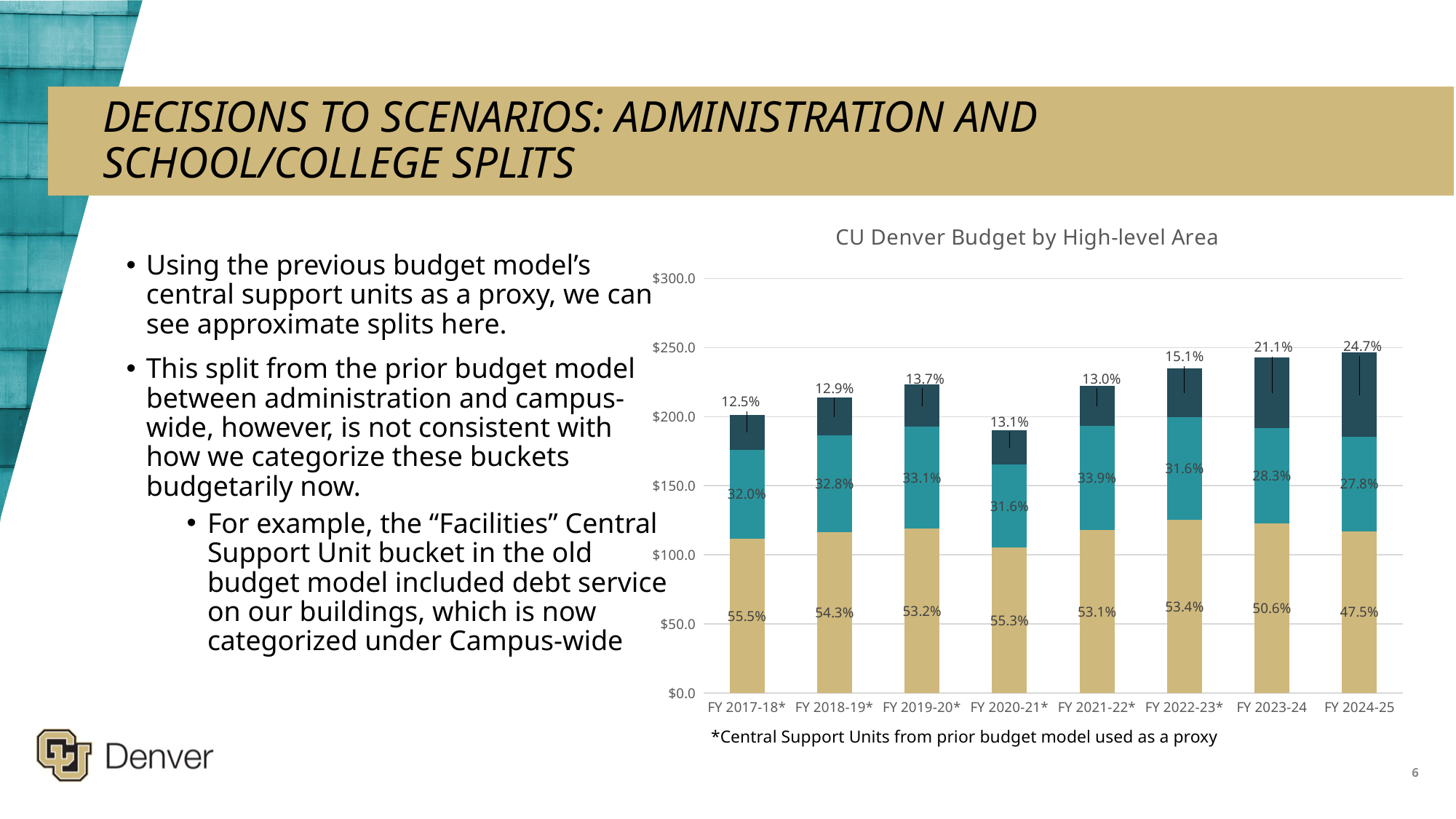
Which fiscal year has the lowest percentage labeled on the bottom segment of its bar? FY 2024-25 By how many percentage points does the bottom-segment label for FY 2017-18* exceed the bottom-segment label for FY 2024-25? 8.0 percentage points What is the title of the chart? CU Denver Budget by High-level Area What percentage is labeled on the middle segment of the bar for FY 2021-22*? 33.9% What percentage is labeled on the bottom segment of the bar for FY 2017-18*? 55.5% Which fiscal year has the highest percentage labeled on the top segment of its bar? FY 2024-25 What percentage is labeled on the top segment of the bar for FY 2024-25? 24.7% How many fiscal years are shown on the x axis of the chart? 8 What kind of chart is shown on the slide? Stacked bar chart Is the total height of the bar for FY 2020-21* greater or less than $200.0? less Do the top-segment percentages rise or fall from FY 2021-22* to FY 2024-25? Rise Which has the larger middle-segment percentage: FY 2021-22* or FY 2023-24? FY 2021-22*